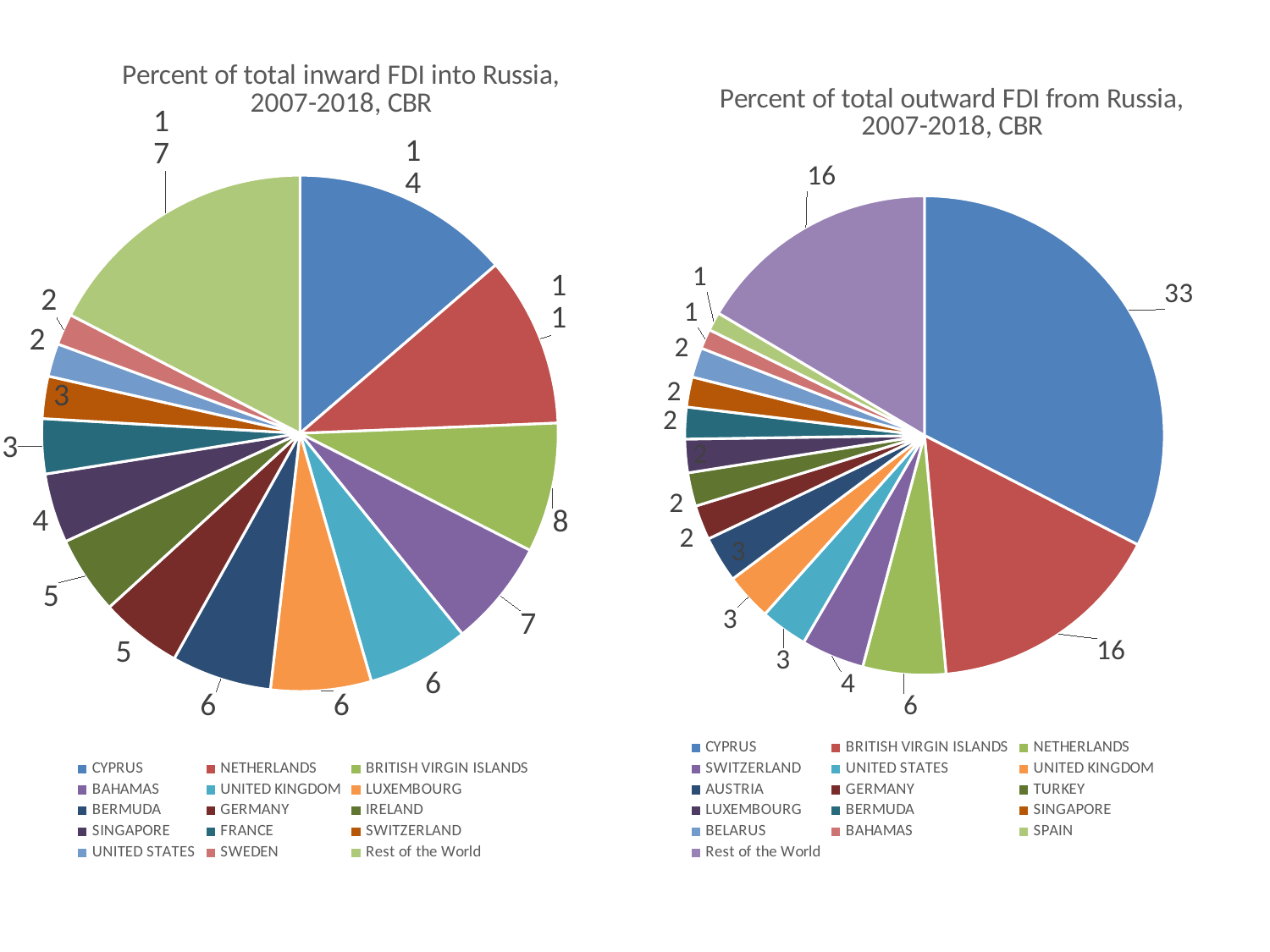
In the chart titled 'Percent of total inward FDI into Russia, 2007-2018, CBR', what value is shown for British Virgin Islands? 8 In the chart titled 'Percent of total inward FDI into Russia, 2007-2018, CBR', which is larger, the value for Bahamas or the value for Germany? Bahamas In the chart titled 'Percent of total inward FDI into Russia, 2007-2018, CBR', what value is shown for Bahamas? 7 How many entries does the legend list for the chart titled 'Percent of total inward FDI into Russia, 2007-2018, CBR'? 15 In the chart titled 'Percent of total outward FDI from Russia, 2007-2018, CBR', what value is shown for Switzerland? 4 In the chart titled 'Percent of total outward FDI from Russia, 2007-2018, CBR', what value is shown for British Virgin Islands? 16 In the chart titled 'Percent of total outward FDI from Russia, 2007-2018, CBR', what is the difference between the values for Cyprus and British Virgin Islands? 17 In the chart titled 'Percent of total outward FDI from Russia, 2007-2018, CBR', what value is shown for Cyprus? 33 What kind of chart is the one titled 'Percent of total inward FDI into Russia, 2007-2018, CBR'? Pie chart In the chart titled 'Percent of total outward FDI from Russia, 2007-2018, CBR', which category has the largest slice? Cyprus In the chart titled 'Percent of total outward FDI from Russia, 2007-2018, CBR', what value is shown for Netherlands? 6 How many entries does the legend list for the chart titled 'Percent of total outward FDI from Russia, 2007-2018, CBR'? 16